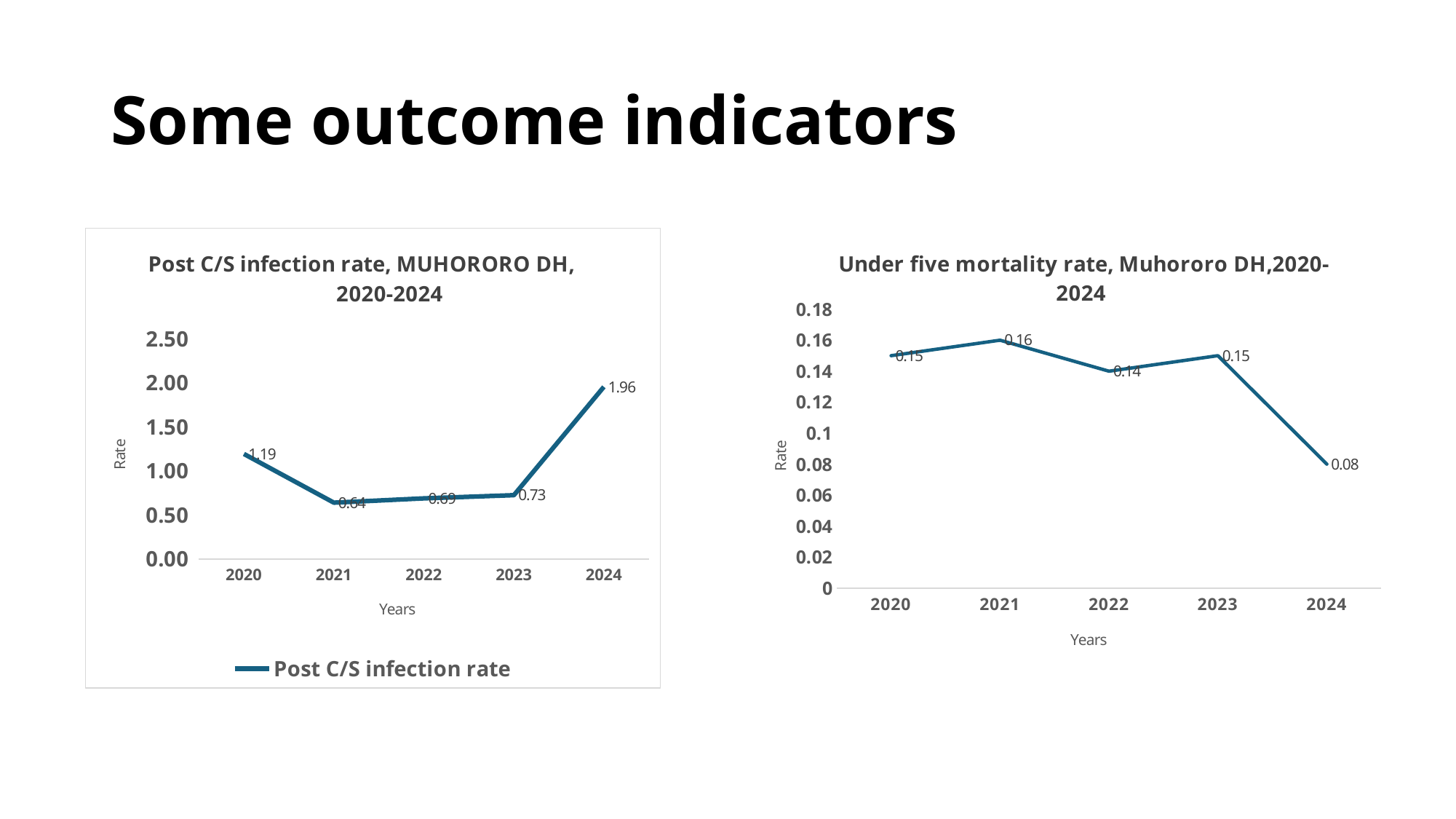
In the 'Post C/S infection rate, MUHORORO DH, 2020-2024' chart, what kind of chart is shown? Line chart In the 'Under five mortality rate, Muhororo DH,2020-2024' chart, which year has the lowest value? 2024 In the 'Post C/S infection rate, MUHORORO DH, 2020-2024' chart, which year has the highest value? 2024 In the 'Under five mortality rate, Muhororo DH,2020-2024' chart, what is the value for 2021? 0.16 In the 'Under five mortality rate, Muhororo DH,2020-2024' chart, how many years are plotted on the x axis? 5 In the 'Post C/S infection rate, MUHORORO DH, 2020-2024' chart, what is the value for 2020? 1.19 In the 'Post C/S infection rate, MUHORORO DH, 2020-2024' chart, which year has the lowest value? 2021 In the 'Post C/S infection rate, MUHORORO DH, 2020-2024' chart, what series name does the legend show? Post C/S infection rate In the 'Under five mortality rate, Muhororo DH,2020-2024' chart, what is the difference between the 2023 and 2024 values? 0.07 In the 'Post C/S infection rate, MUHORORO DH, 2020-2024' chart, what is the difference between the 2024 and 2023 values? 1.23 In the 'Post C/S infection rate, MUHORORO DH, 2020-2024' chart, what is the value for 2024? 1.96 In the 'Under five mortality rate, Muhororo DH,2020-2024' chart, what is the value for 2024? 0.08